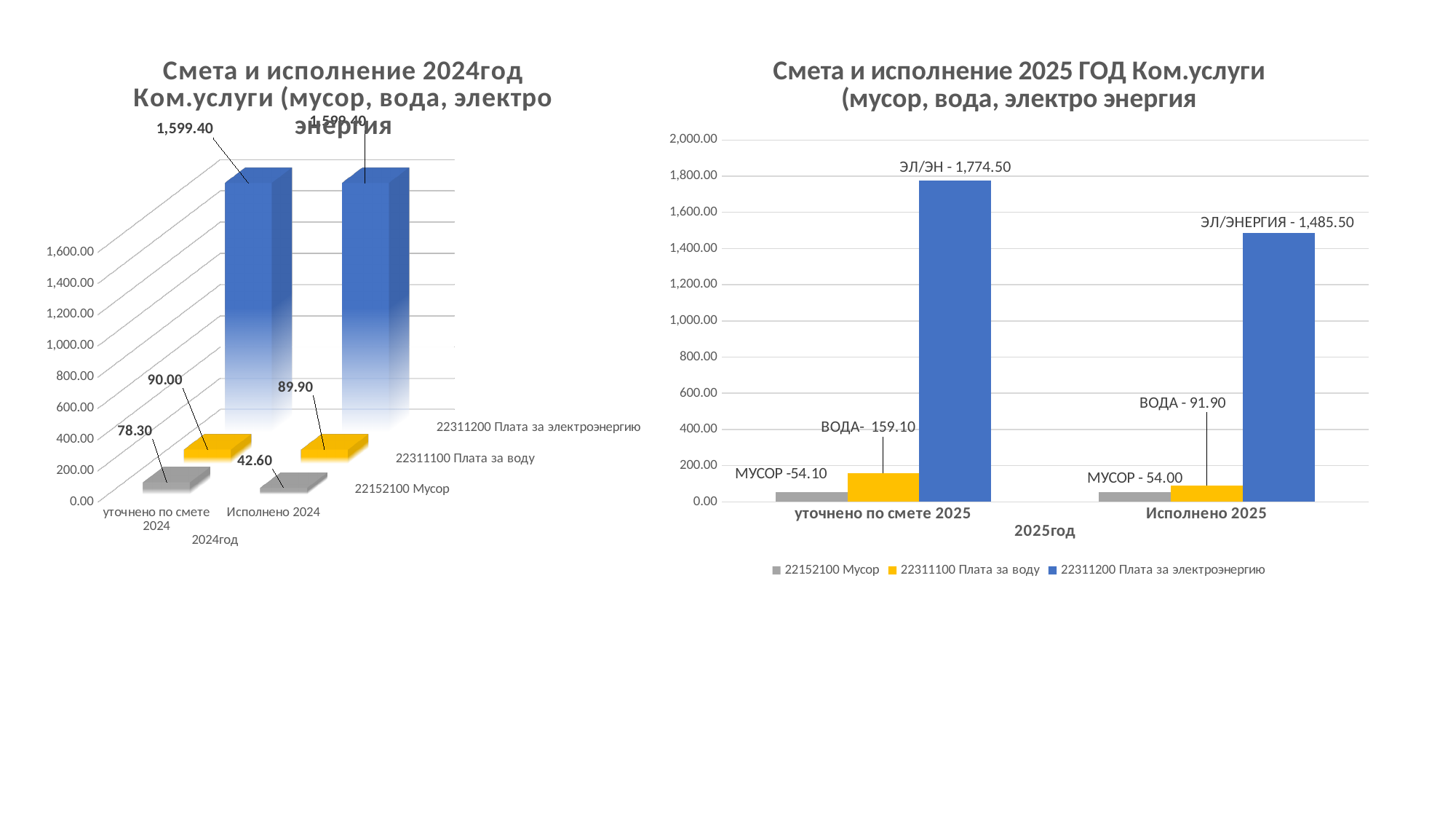
In the right chart (Смета и исполнение 2025 ГОД), what colour are the bars for 22311100 Плата за воду? yellow In the right chart (Смета и исполнение 2025 ГОД), what is the difference between the electricity values for 'уточнено по смете 2025' and 'Исполнено 2025'? 289.00 In the right chart (Смета и исполнение 2025 ГОД), what is the value for water (ВОДА) under 'Исполнено 2025'? 91.90 In the right chart (Смета и исполнение 2025 ГОД), which series has the highest value under 'Исполнено 2025'? 22311200 Плата за электроэнергию In the left chart (Смета и исполнение 2024год), what is the value for 22311100 Плата за воду under 'уточнено по смете 2024'? 90.00 In the right chart (Смета и исполнение 2025 ГОД), what is the value for electricity (ЭЛ/ЭН) under 'уточнено по смете 2025'? 1,774.50 In the right chart (Смета и исполнение 2025 ГОД), how many series does the legend list? 3 In the left chart (Смета и исполнение 2024год), what is the value for 22152100 Мусор under 'Исполнено 2024'? 42.60 In the right chart (Смета и исполнение 2025 ГОД), which is larger: the water value for 'уточнено по смете 2025' or for 'Исполнено 2025'? уточнено по смете 2025 What kind of chart is the left chart (Смета и исполнение 2024год)? bar chart In the left chart (Смета и исполнение 2024год), what is the difference between the Мусор values for 'уточнено по смете 2024' and 'Исполнено 2024'? 35.70 In the right chart (Смета и исполнение 2025 ГОД), what is the value for garbage (МУСОР) under 'уточнено по смете 2025'? 54.10